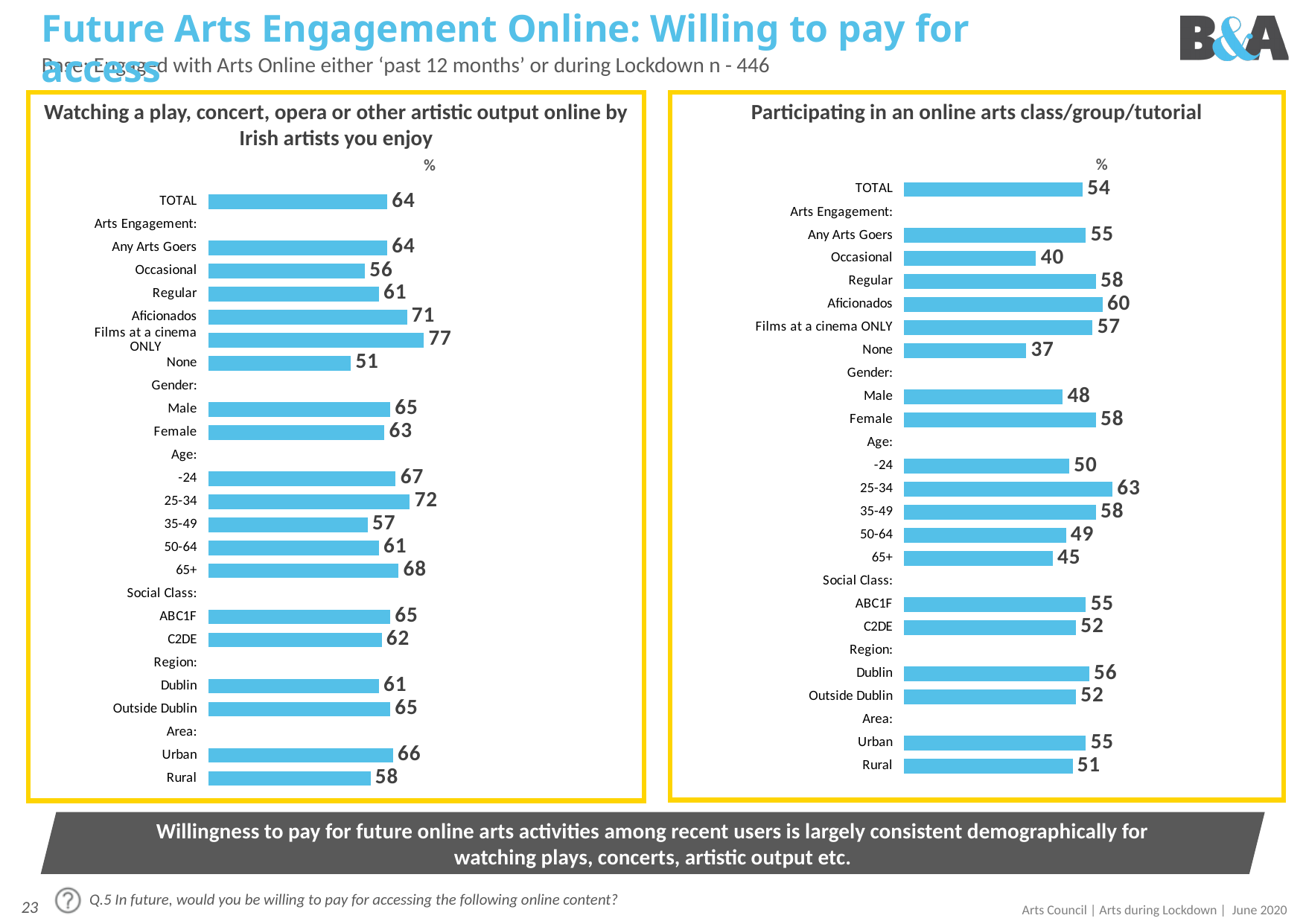
In the chart 'Watching a play, concert, opera or other artistic output online by Irish artists you enjoy', which is larger, the value for Urban or the value for Rural? Urban What type of chart is used on the left side of the slide? Bar chart In the chart 'Watching a play, concert, opera or other artistic output online by Irish artists you enjoy', which category has the highest value? Films at a cinema ONLY In the chart 'Participating in an online arts class/group/tutorial', which is larger, the value for Male or the value for Female? Female In the chart 'Participating in an online arts class/group/tutorial', what is the value for 25-34? 63 How many charts are shown on the slide? 2 In the chart 'Watching a play, concert, opera or other artistic output online by Irish artists you enjoy', what is the difference between the values for 25-34 and 35-49? 15 In the chart 'Participating in an online arts class/group/tutorial', which category has the lowest value? None In the chart 'Watching a play, concert, opera or other artistic output online by Irish artists you enjoy', what is the value for Rural? 58 In the chart 'Participating in an online arts class/group/tutorial', what is the difference between the values for Dublin and Outside Dublin? 4 In the chart 'Participating in an online arts class/group/tutorial', what is the value for Occasional? 40 In the chart 'Watching a play, concert, opera or other artistic output online by Irish artists you enjoy', what is the value for TOTAL? 64